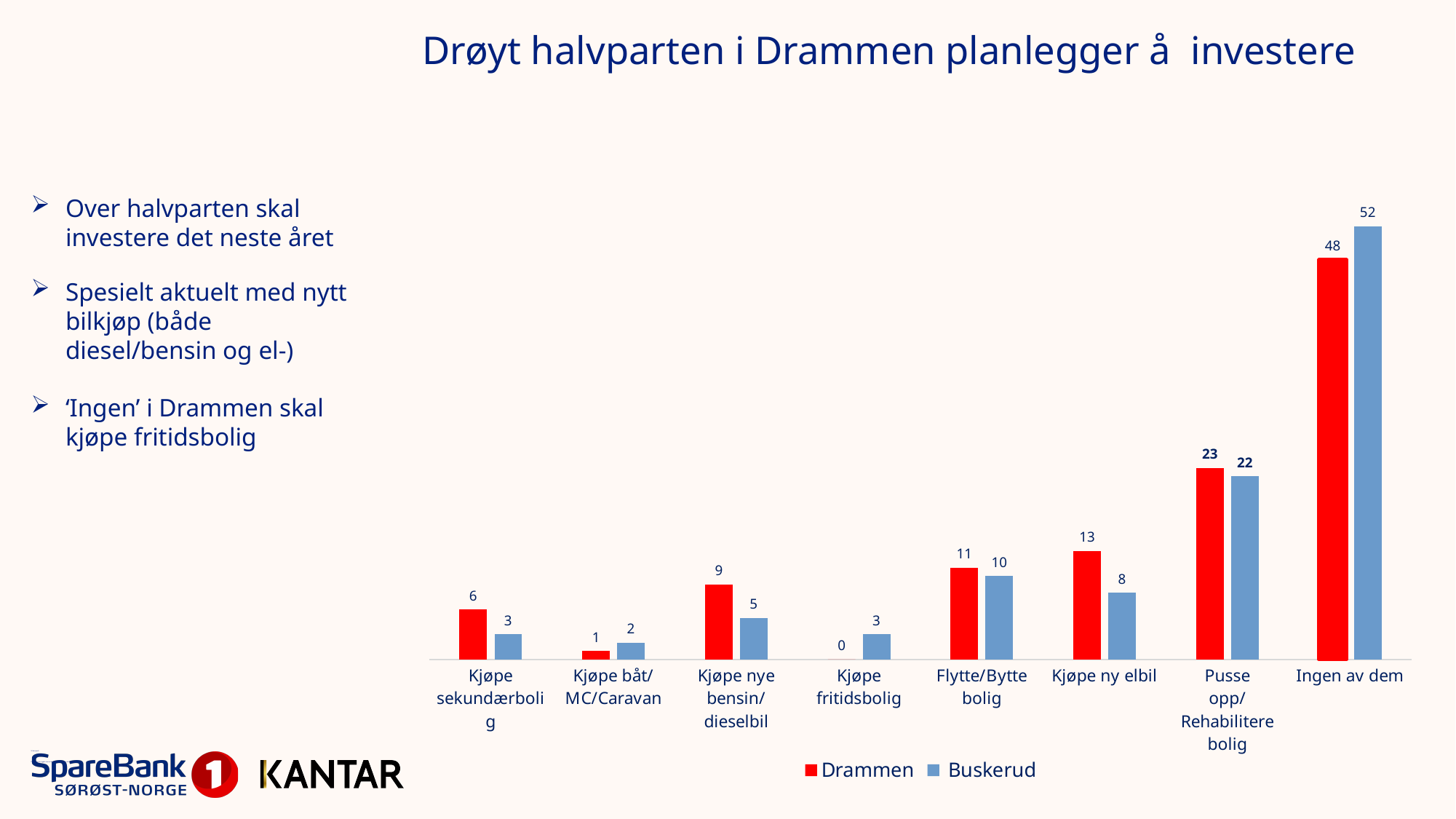
How many categories are shown on the x axis? 8 Which category has the lowest value for Drammen? Kjøpe fritidsbolig What is the value for Buskerud in the 'Kjøpe ny elbil' category? 8 What is the value for Buskerud in the 'Pusse opp/Rehabilitere bolig' category? 22 How many series does the legend list? 2 Which colour represents the Drammen series in the chart? Red Which category has the highest value for Buskerud? Ingen av dem What is the value for Drammen in the 'Ingen av dem' category? 48 What is the value for Drammen in the 'Kjøpe fritidsbolig' category? 0 What kind of chart is shown on the slide? Bar chart What is the difference between the Drammen and Buskerud values for 'Kjøpe ny elbil'? 5 Which is larger for 'Ingen av dem': the Drammen value or the Buskerud value? Buskerud